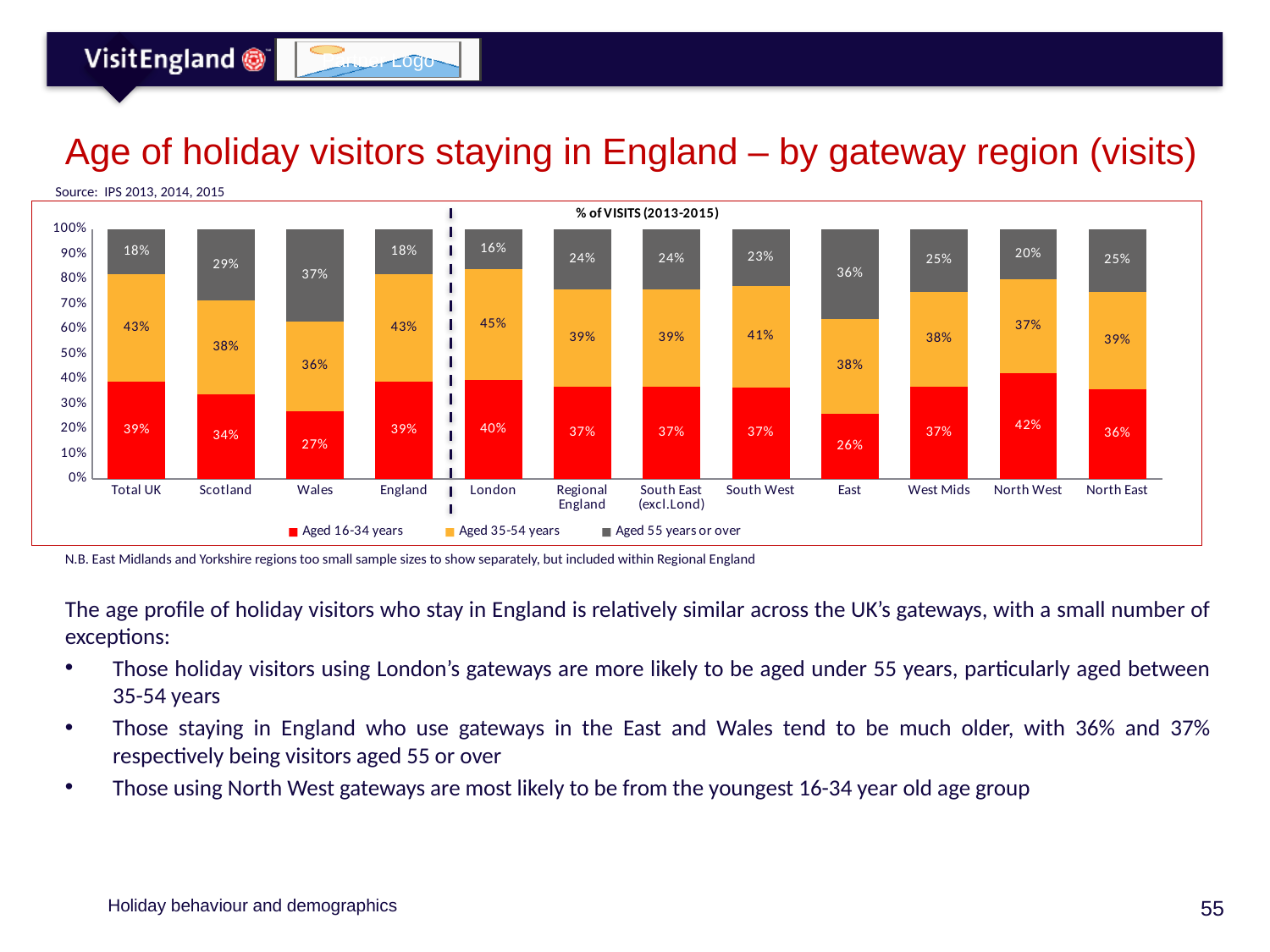
What share of visitors using East gateways are aged 16-34 years? 26% What is the value for Aged 55 years or over for Wales? 37% Which is larger: the Aged 35-54 years value for London or for Scotland? London Which gateway region has the lowest percentage of visitors aged 55 years or over? London What is the total of the stacked bar for Total UK? 100% What is the difference between the Aged 55 years or over percentages for Wales and Total UK? 19 percentage points Which gateway region has the highest percentage of visitors aged 16-34 years? North West How many gateway regions (categories) are shown on the x axis? 12 What percentage of holiday visitors using London gateways are aged 35-54 years? 45% What is the title shown inside the chart area? % of VISITS (2013-2015) How many series does the legend list? 3 What kind of chart is shown on the slide? Stacked bar chart